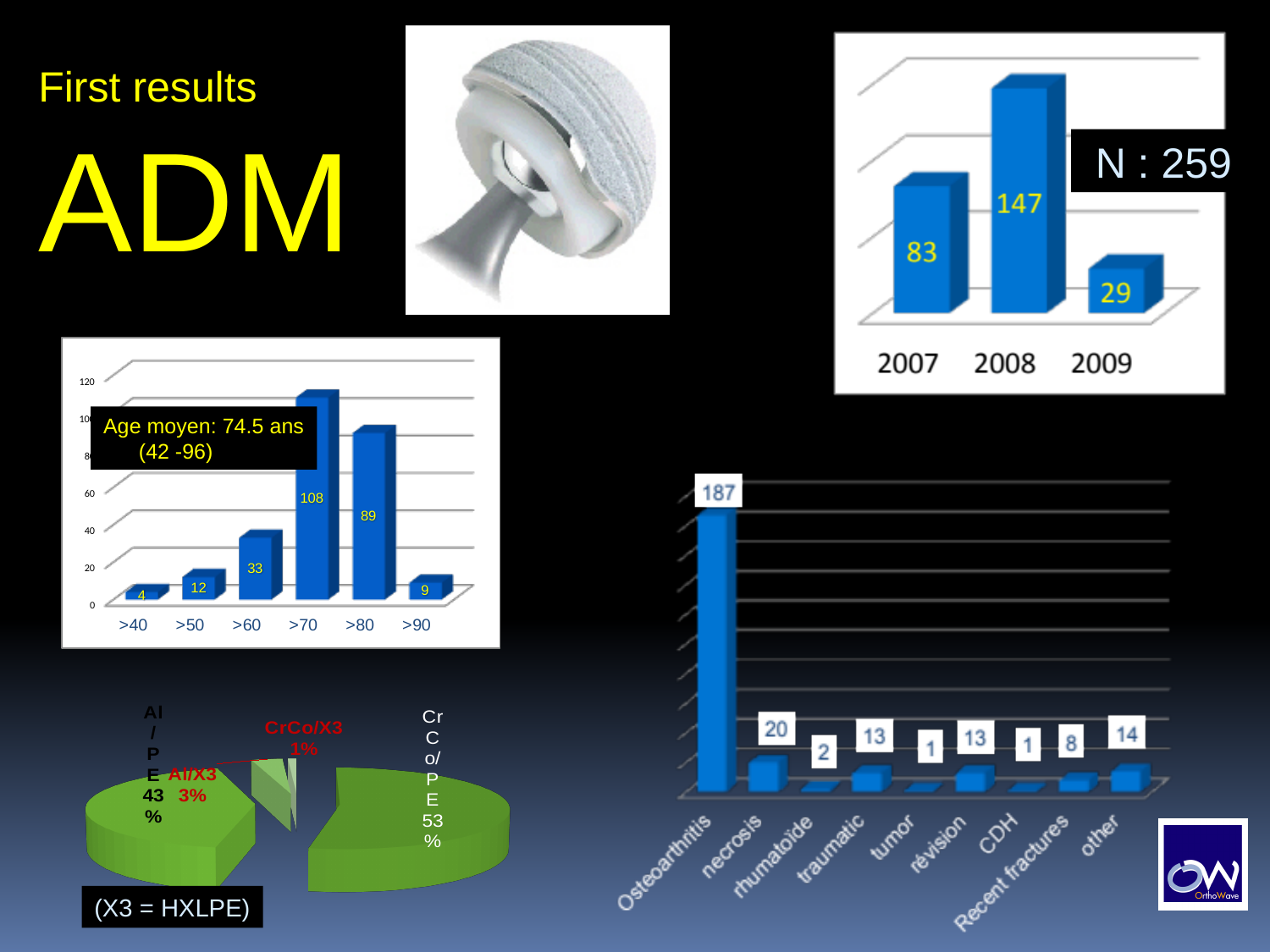
In the age distribution bar chart on the left, which category has the highest value? >70 In the age distribution bar chart on the left, what is the value for the >70 category? 108 In the diagnosis bar chart at the bottom right, what is the value for Osteoarthritis? 187 In the pie chart at the bottom left, what share does CrCo/PE have? 53% In the age distribution bar chart on the left, which is larger, the value for >60 or the value for >80? >80 In the bar chart by year at the top right, which year has the lowest value? 2009 In the age distribution bar chart on the left, how many age categories are shown on the x axis? 6 In the pie chart at the bottom left, which slice is the smallest? CrCo/X3 In the bar chart by year at the top right, what is the difference between the values for 2008 and 2007? 64 In the bar chart by year at the top right, what is the value for 2008? 147 In the diagnosis bar chart at the bottom right, what is the value for necrosis? 20 In the age distribution bar chart on the left, what is the difference between the values for >80 and >90? 80